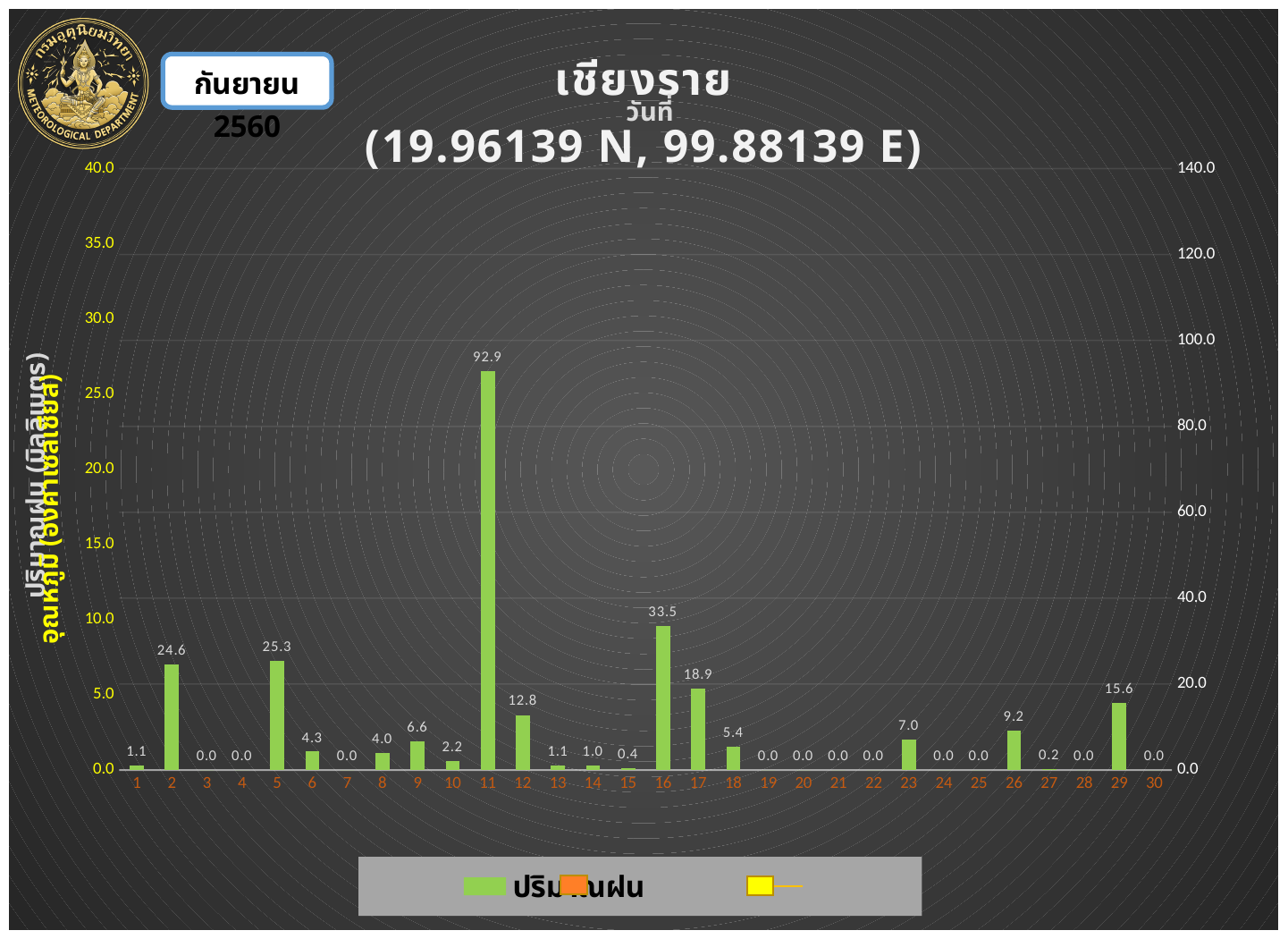
Which day has the highest bar in the chart? 11 What kind of chart is shown on the slide? bar chart Is the value for day 11 greater or less than 80.0 on the right-hand axis? greater What is the value labelled on the bar for day 26? 9.2 What is the difference between the values for day 16 and day 17? 14.6 How many days are shown along the x axis? 30 Which day has the larger value, day 17 or day 29? 17 What is the value labelled on the bar for day 16? 33.5 What is the main title of the chart? เชียงราย What is the difference between the values for day 5 and day 2? 0.7 What is the value labelled on the bar for day 29? 15.6 What is the rainfall value shown for day 11? 92.9